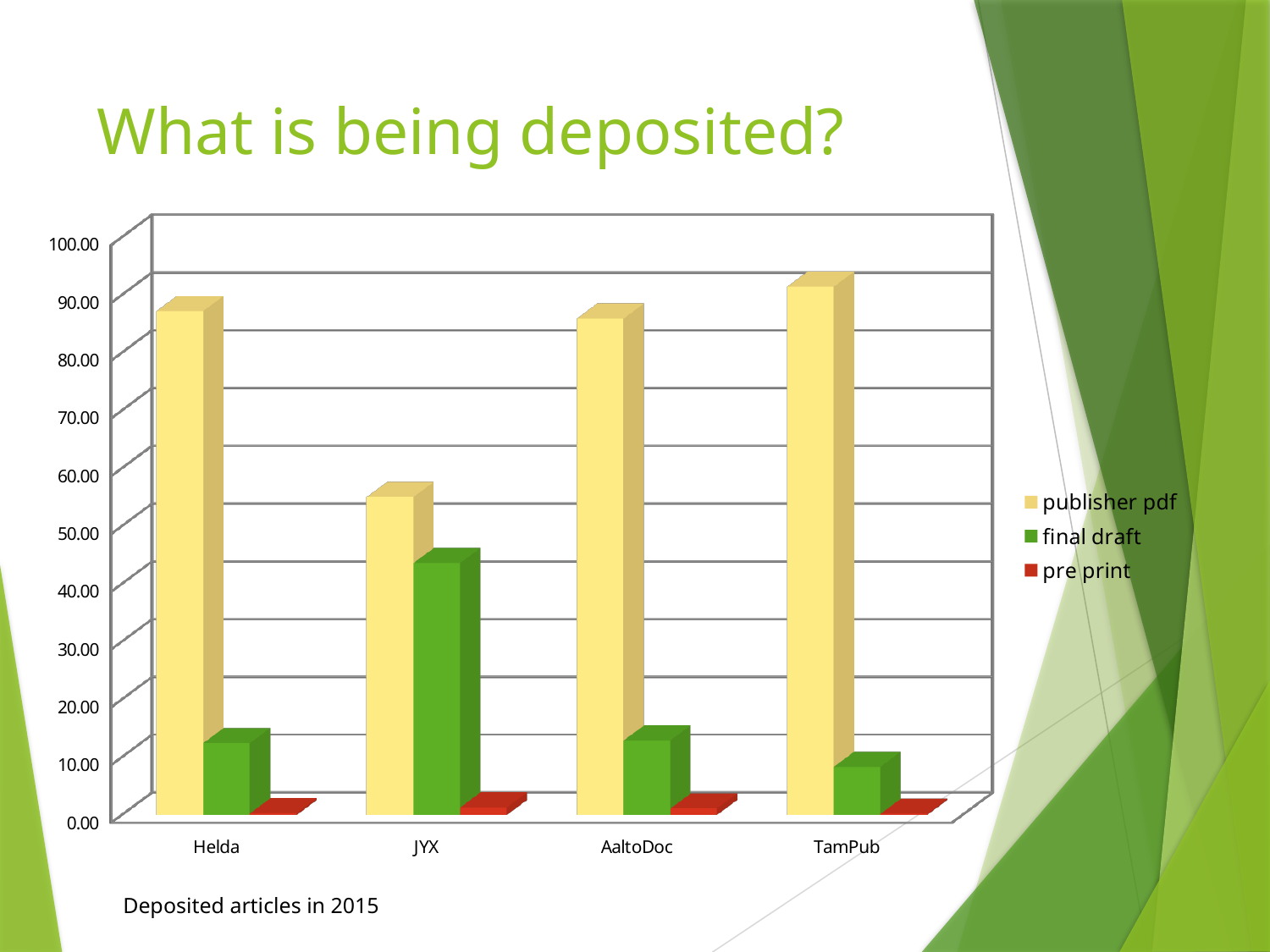
Which repository has the highest publisher pdf value? TamPub Is the final draft value for JYX greater or less than 50.00? less Is the publisher pdf value for Helda greater or less than 80.00? greater Is the final draft value for TamPub greater or less than 20.00? less For JYX, which is larger: publisher pdf or final draft? publisher pdf What kind of chart is shown on the slide? bar chart How many series does the legend list? 3 How many repositories (categories) are shown on the x axis? 4 Which repository has the lowest publisher pdf value? JYX What caption appears below the chart? Deposited articles in 2015 Which repository has the highest final draft value? JYX